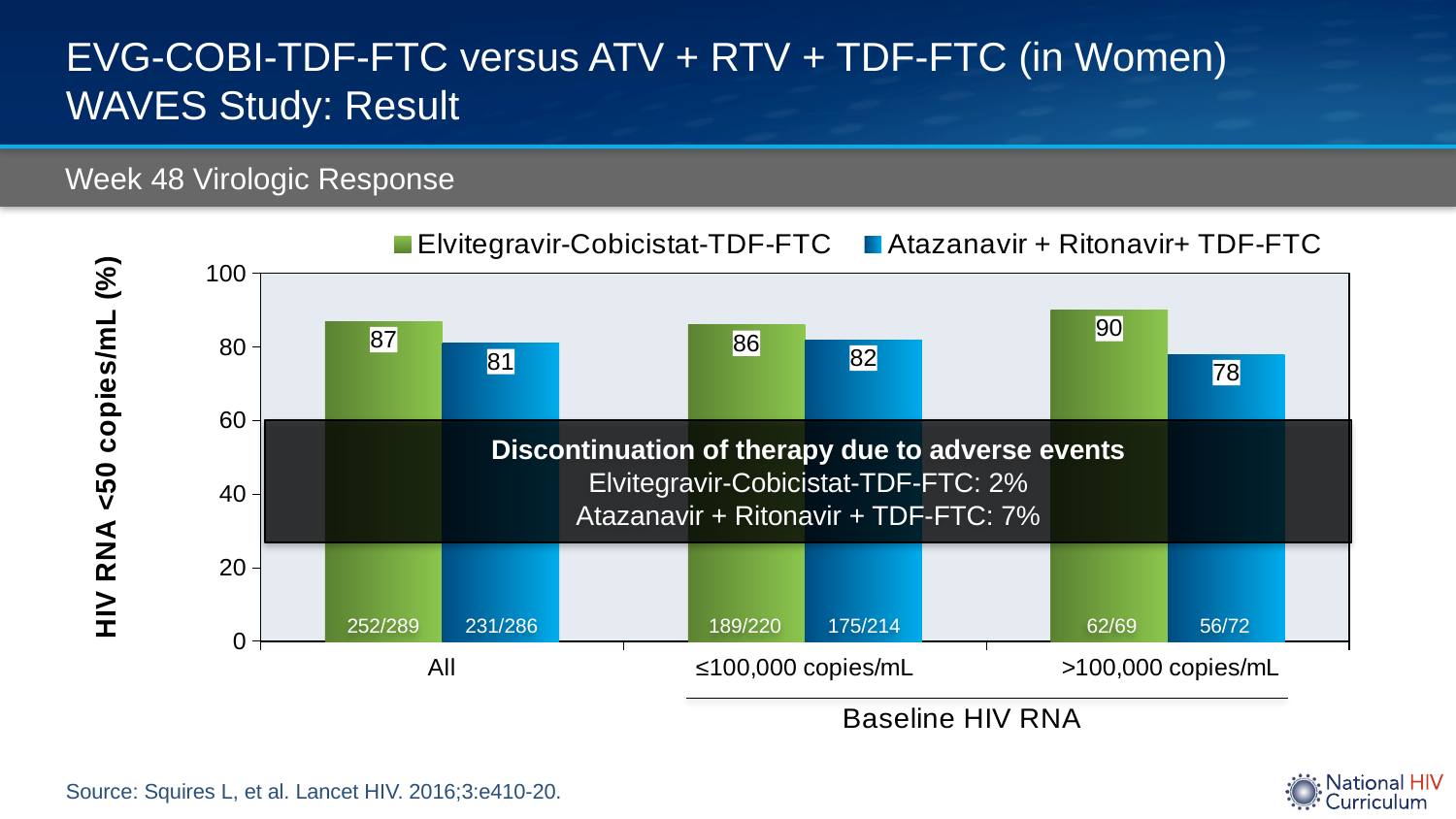
What is the value for Elvitegravir-Cobicistat-TDF-FTC in the All group? 87 How many baseline HIV RNA categories are shown on the x axis? 3 Which baseline HIV RNA category has the highest value for Elvitegravir-Cobicistat-TDF-FTC? >100,000 copies/mL In the ≤100,000 copies/mL group, which series has the larger value? Elvitegravir-Cobicistat-TDF-FTC Which baseline HIV RNA category has the lowest value for Atazanavir + Ritonavir+ TDF-FTC? >100,000 copies/mL What is the difference between the Elvitegravir-Cobicistat-TDF-FTC and Atazanavir + Ritonavir+ TDF-FTC values in the All group? 6 What is the value for Atazanavir + Ritonavir+ TDF-FTC in the >100,000 copies/mL group? 78 What is the y-axis label of the chart? HIV RNA <50 copies/mL (%) What is the difference between the Elvitegravir-Cobicistat-TDF-FTC and Atazanavir + Ritonavir+ TDF-FTC values in the >100,000 copies/mL group? 12 What kind of chart is shown on the slide? Bar chart How many series does the legend list? 2 What is the value for Atazanavir + Ritonavir+ TDF-FTC in the ≤100,000 copies/mL group? 82